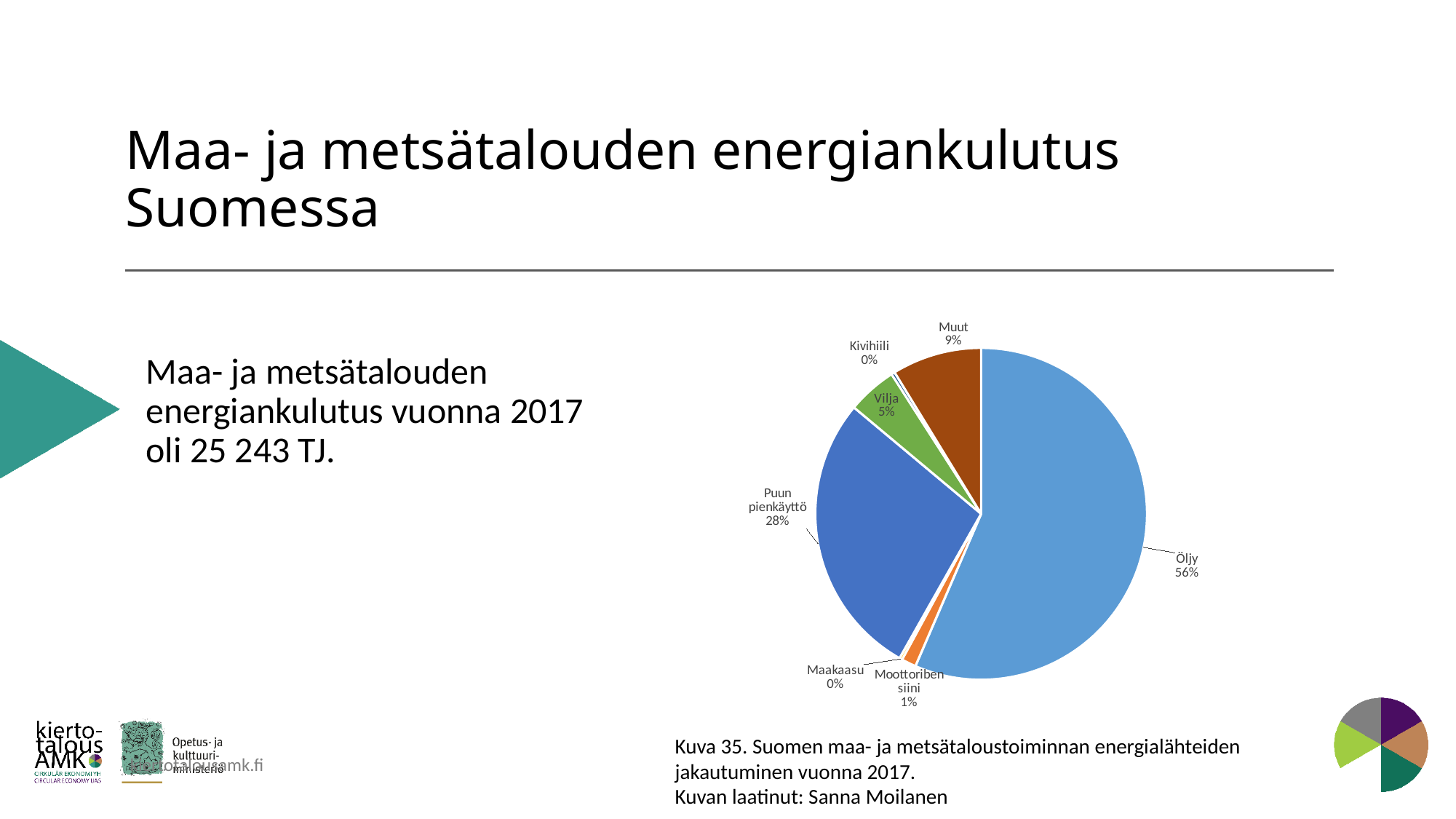
What percentage is shown for Vilja? 5% What is the combined share of Öljy and Puun pienkäyttö? 84% Which is larger, the share for Muut or the share for Vilja? Muut What percentage is shown for Muut? 9% Which slice of the pie is the largest? Öljy How many slices are labelled in the pie chart? 7 What share of the pie does Öljy have? 56% What share of the pie does Puun pienkäyttö have? 28% Which two categories are labelled with 0%? Kivihiili and Maakaasu What is the difference in percentage points between Öljy and Puun pienkäyttö? 28 What kind of chart is shown on the slide? pie chart What percentage is shown for Moottoribensiini? 1%